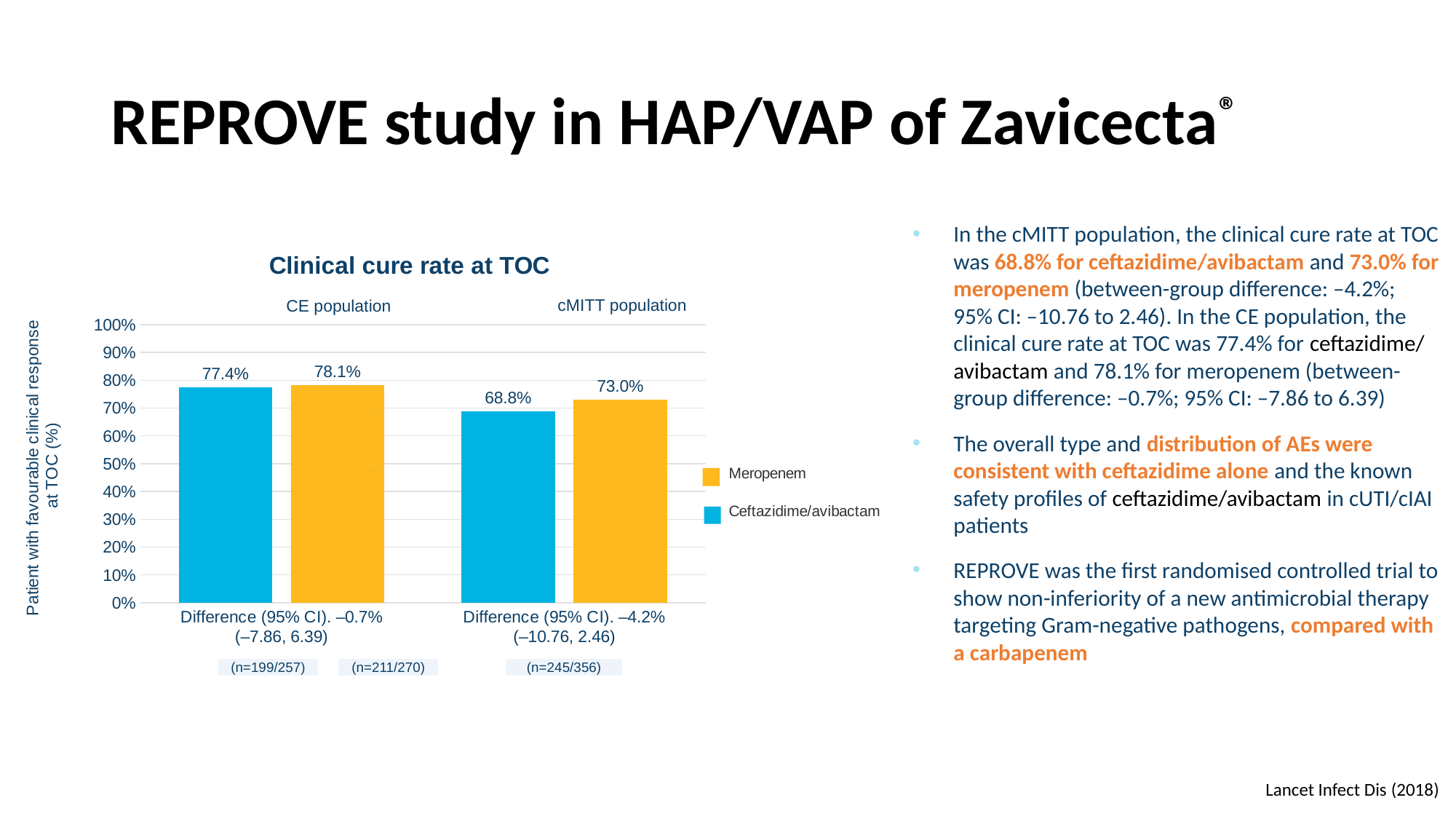
What is the title of the chart? Clinical cure rate at TOC What is the clinical cure rate for Ceftazidime/avibactam in the CE population? 77.4% What is the clinical cure rate for Ceftazidime/avibactam in the cMITT population? 68.8% What is the difference between the Meropenem and Ceftazidime/avibactam cure rates in the cMITT population? 4.2% How many series does the legend list? 2 What is the clinical cure rate for Meropenem in the cMITT population? 73.0% What kind of chart is shown on the slide? Bar chart Which bar shows the lowest clinical cure rate? Ceftazidime/avibactam in the cMITT population In the cMITT population, which treatment has the higher clinical cure rate? Meropenem Which bar shows the highest clinical cure rate? Meropenem in the CE population What is the clinical cure rate for Meropenem in the CE population? 78.1% Which colour represents Meropenem in the chart? Orange